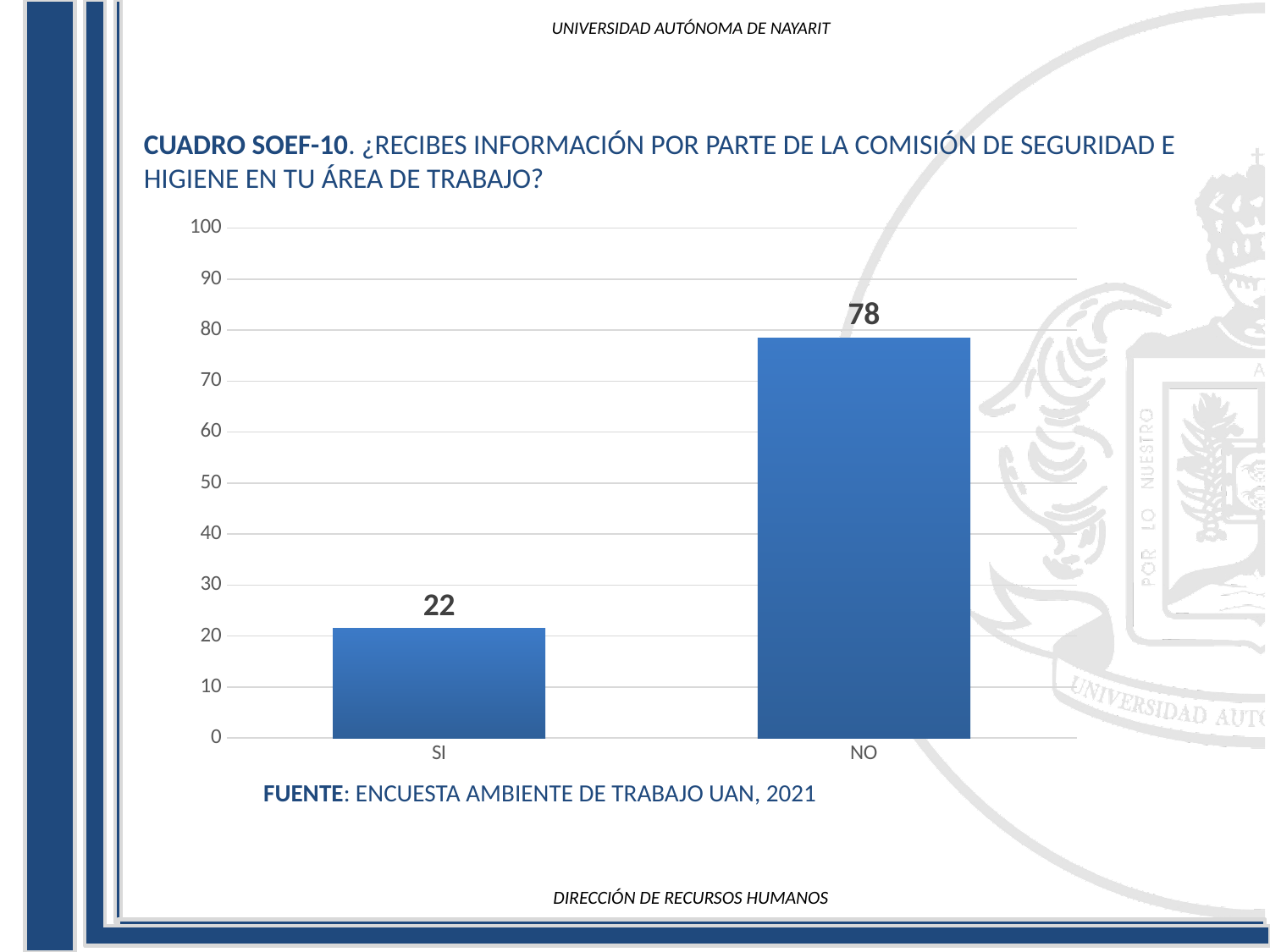
What is the total of the two bar values? 100 What is the value for SI? 22 Is the value for NO greater or less than 70? greater How many categories are shown on the x axis? 2 What source is cited below the chart? ENCUESTA AMBIENTE DE TRABAJO UAN, 2021 Which is larger, the value for SI or the value for NO? NO Is the value for SI greater or less than 30? less What kind of chart is shown on the slide? bar chart What is the value for NO? 78 Which category has the lowest value? SI Which category has the highest value? NO What is the difference between the values for NO and SI? 56